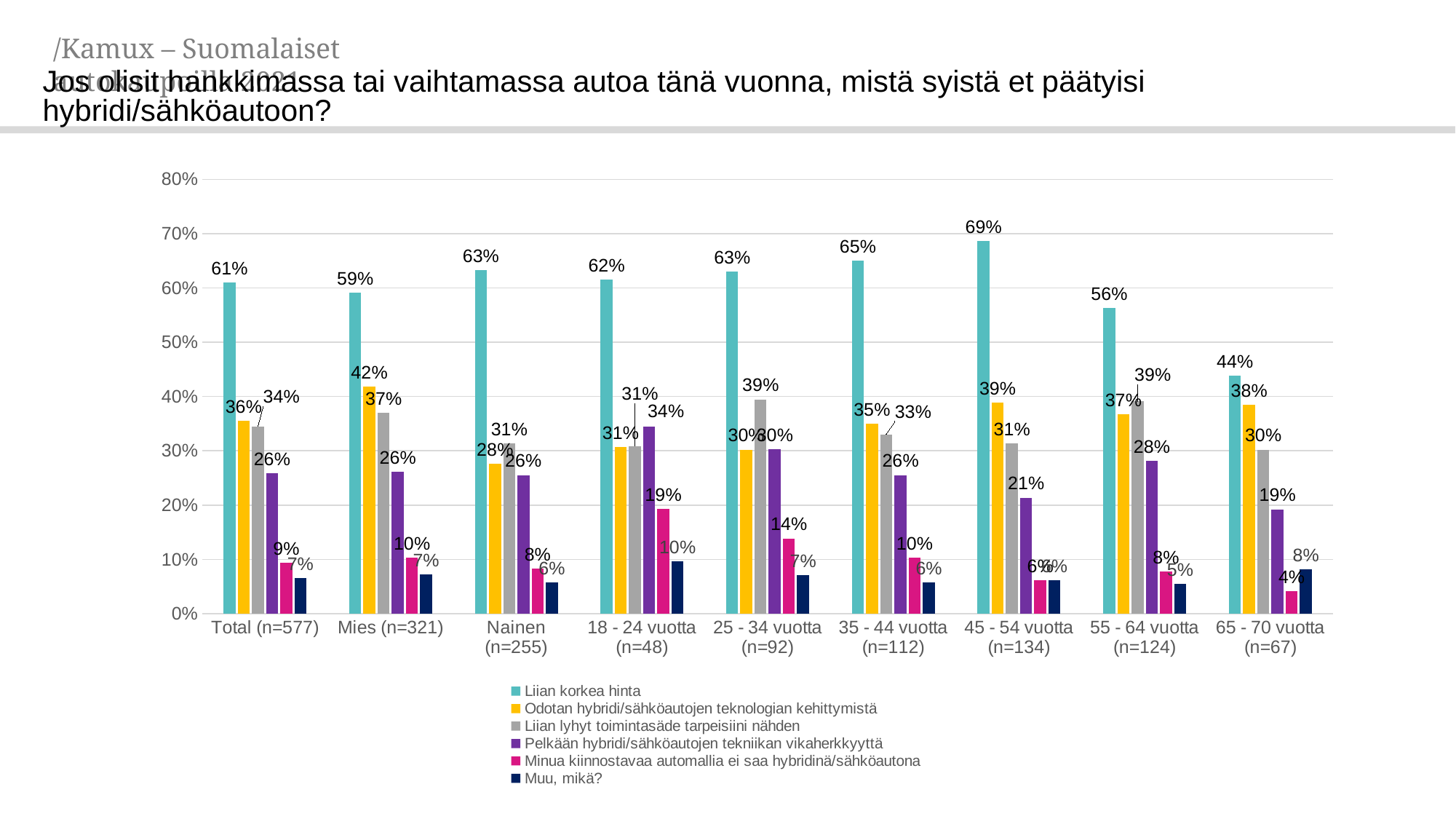
How many categories are shown on the x axis? 9 Which category has the lowest value for "Liian korkea hinta"? 65 - 70 vuotta (n=67) What is the value of "Pelkään hybridi/sähköautojen tekniikan vikaherkkyyttä" for 65 - 70 vuotta (n=67)? 19% What kind of chart is shown on the slide? bar chart How many series does the legend list? 6 What is the value of "Liian korkea hinta" for 45 - 54 vuotta (n=134)? 69% What is the value of "Odotan hybridi/sähköautojen teknologian kehittymistä" for Mies (n=321)? 42% What is the value of "Minua kiinnostavaa automallia ei saa hybridinä/sähköautona" for 18 - 24 vuotta (n=48)? 19% Is the value of "Liian korkea hinta" for Total (n=577) greater or less than 50%? greater What is the difference between the "Liian korkea hinta" values for Nainen (n=255) and Mies (n=321)? 4% Which category has the highest value for "Liian korkea hinta"? 45 - 54 vuotta (n=134) Which is larger for 55 - 64 vuotta (n=124): "Odotan hybridi/sähköautojen teknologian kehittymistä" or "Liian lyhyt toimintasäde tarpeisiini nähden"? Liian lyhyt toimintasäde tarpeisiini nähden